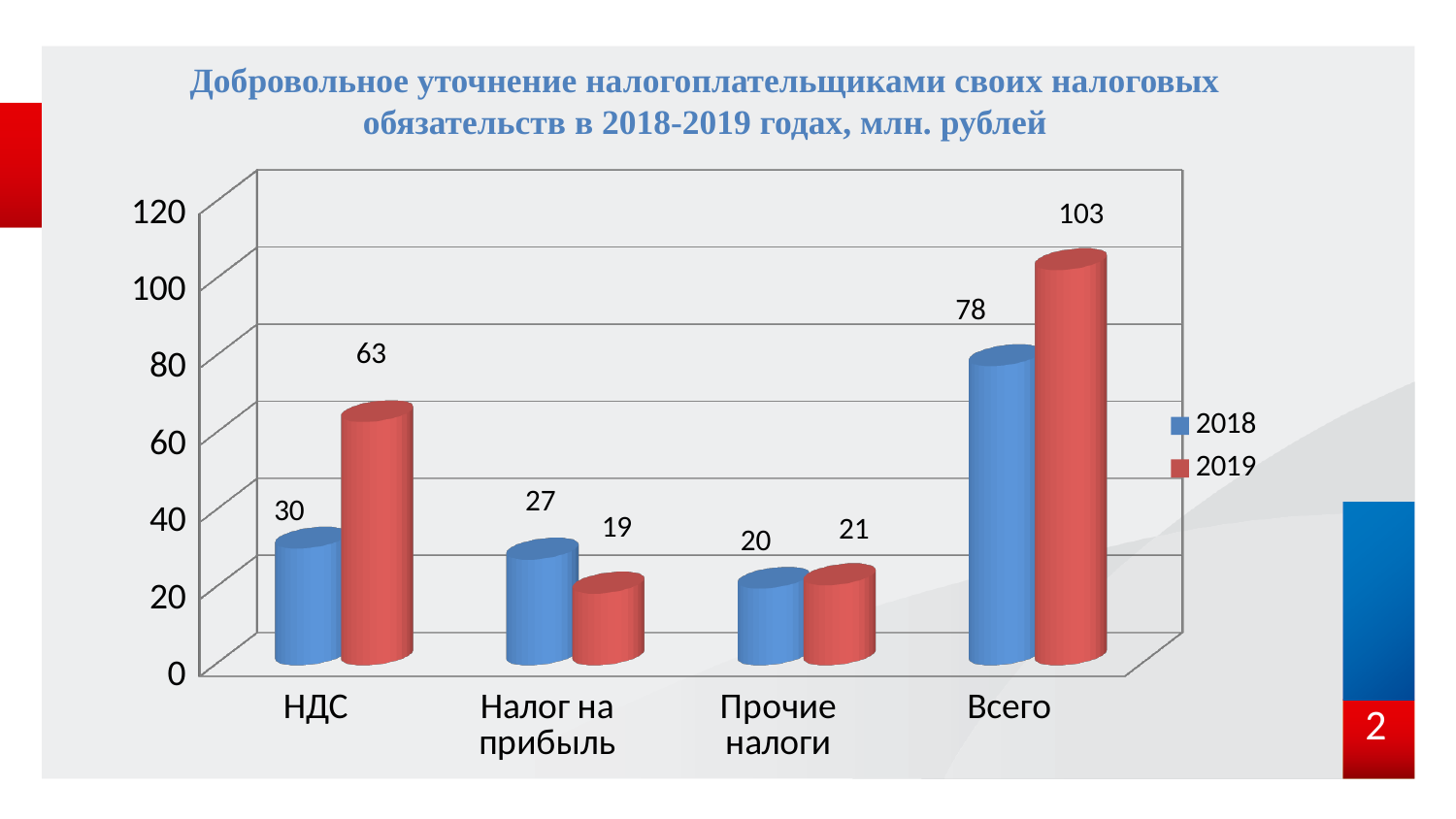
Which is larger for Налог на прибыль: the 2018 value or the 2019 value? 2018 What is the value for НДС in 2019? 63 What is the value for Всего in 2018? 78 How many series does the legend list? 2 Which category has the highest value in the 2019 series? Всего What is the value for Налог на прибыль in 2018? 27 Which colour represents the 2019 series? Red Which category has the lowest value in the 2018 series? Прочие налоги What is the difference between the 2019 and 2018 values for НДС? 33 What kind of chart is shown on the slide? Bar chart What is the value for Прочие налоги in 2019? 21 How many categories are shown on the x axis? 4